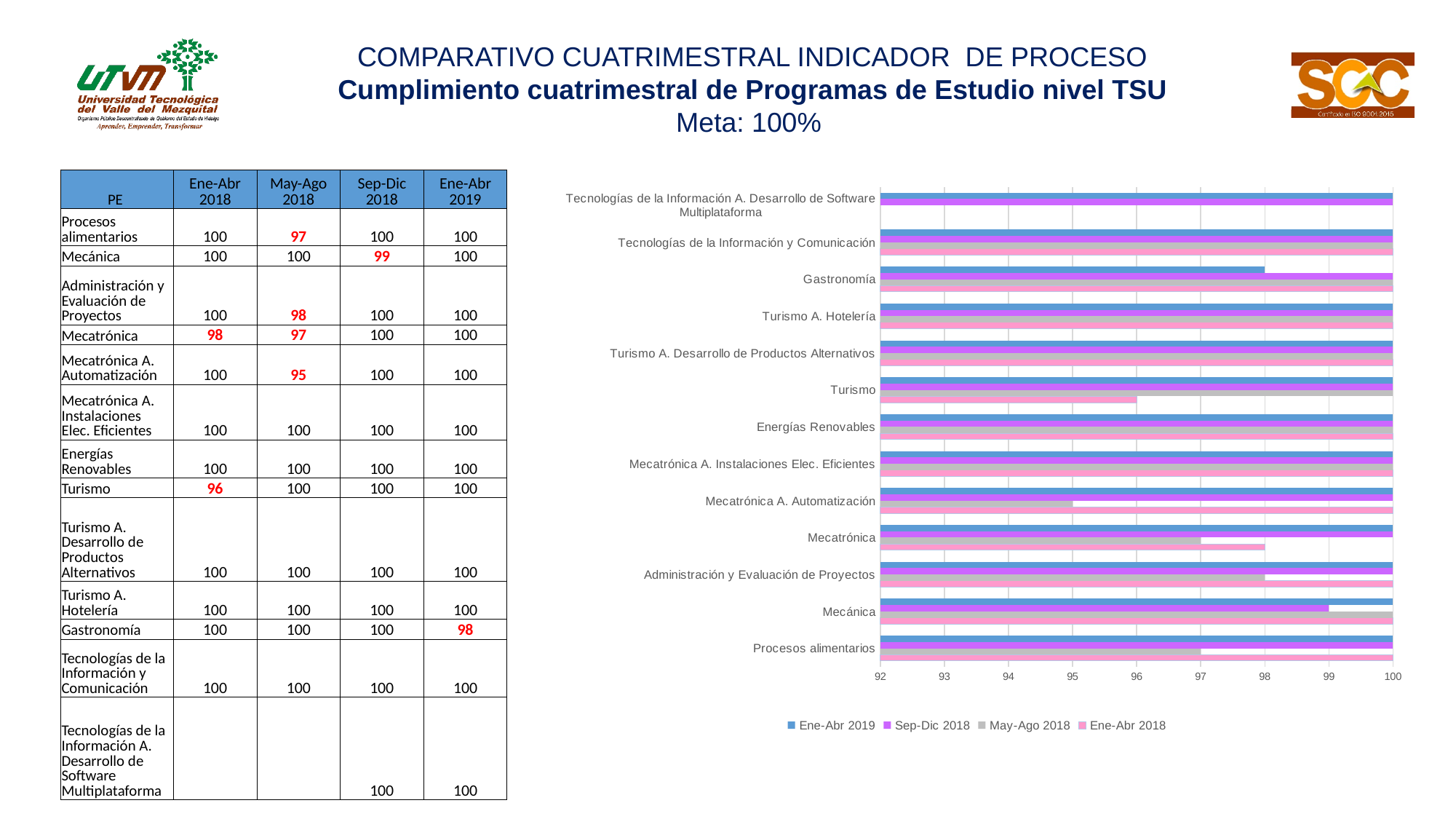
What is the Ene-Abr 2018 value for Turismo? 96 What kind of chart is shown on the slide? bar chart What is the Ene-Abr 2019 value for Gastronomía? 98 What is the May-Ago 2018 value for Mecatrónica A. Automatización? 95 What is the difference between the Ene-Abr 2019 value and the May-Ago 2018 value for Mecatrónica A. Automatización? 5 Which colour represents the Ene-Abr 2019 series in the chart? blue How many series does the chart legend list? 4 Which is larger: the Sep-Dic 2018 value for Mecánica or the May-Ago 2018 value for Procesos alimentarios? Sep-Dic 2018 value for Mecánica How many programs (categories) are plotted on the chart? 13 What is the Sep-Dic 2018 value for Mecánica? 99 Which program has the lowest May-Ago 2018 value? Mecatrónica A. Automatización Which program has the lowest Ene-Abr 2018 value? Turismo